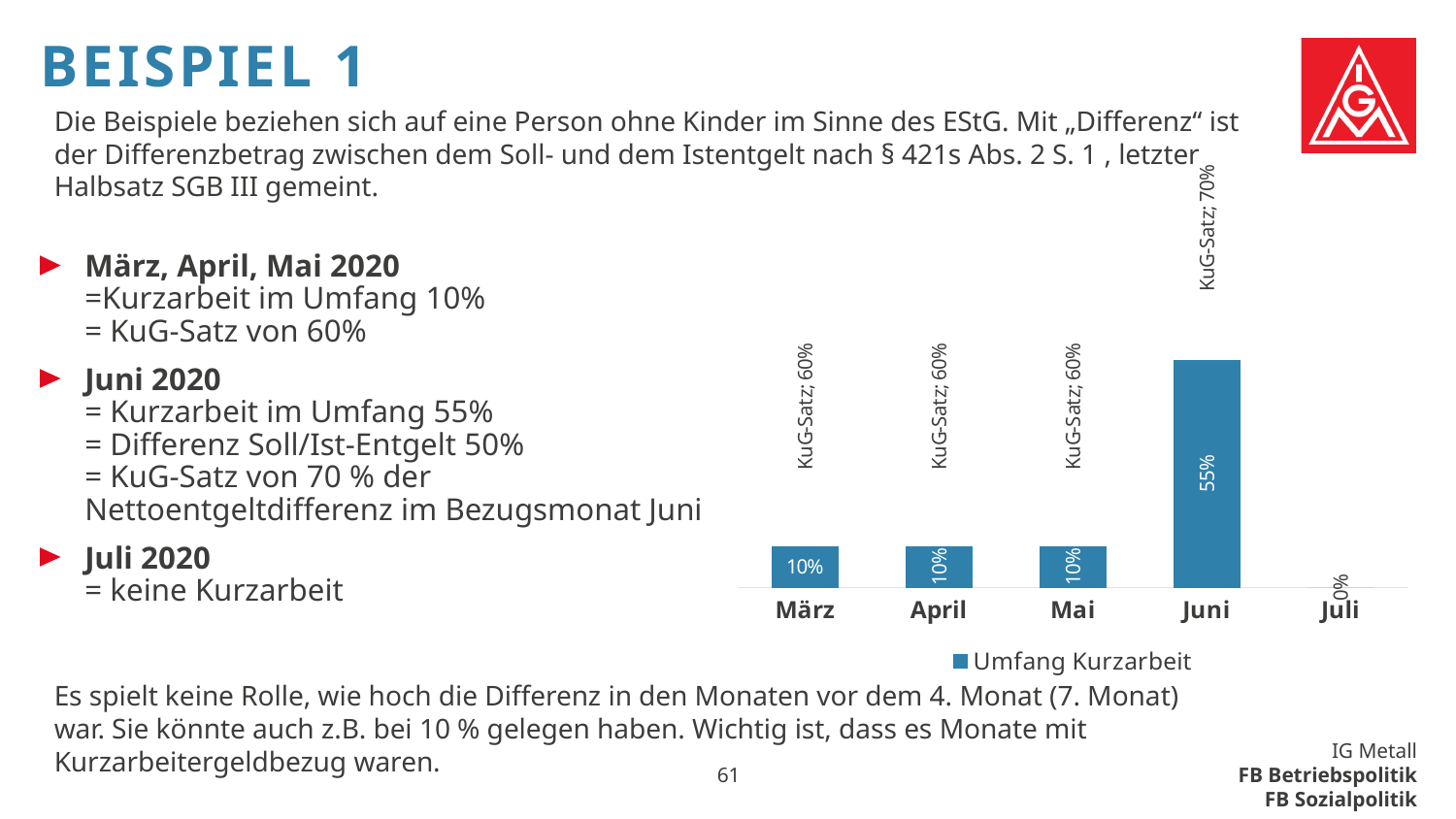
What is the legend entry of the chart? Umfang Kurzarbeit Which is larger, the Umfang Kurzarbeit for April or for Juni? Juni Which month has the highest Umfang Kurzarbeit? Juni What KuG-Satz is labelled above the Juni bar? KuG-Satz; 70% What is the value of Umfang Kurzarbeit for Juni? 55% Which month has the lowest Umfang Kurzarbeit? Juli What is the value of Umfang Kurzarbeit for März? 10% How many months are shown on the x axis of the chart? 5 What is the value of Umfang Kurzarbeit for Juli? 0% How many series does the legend list? 1 What kind of chart is shown on the slide? Bar chart What is the difference between the Umfang Kurzarbeit for Juni and for Mai? 45%